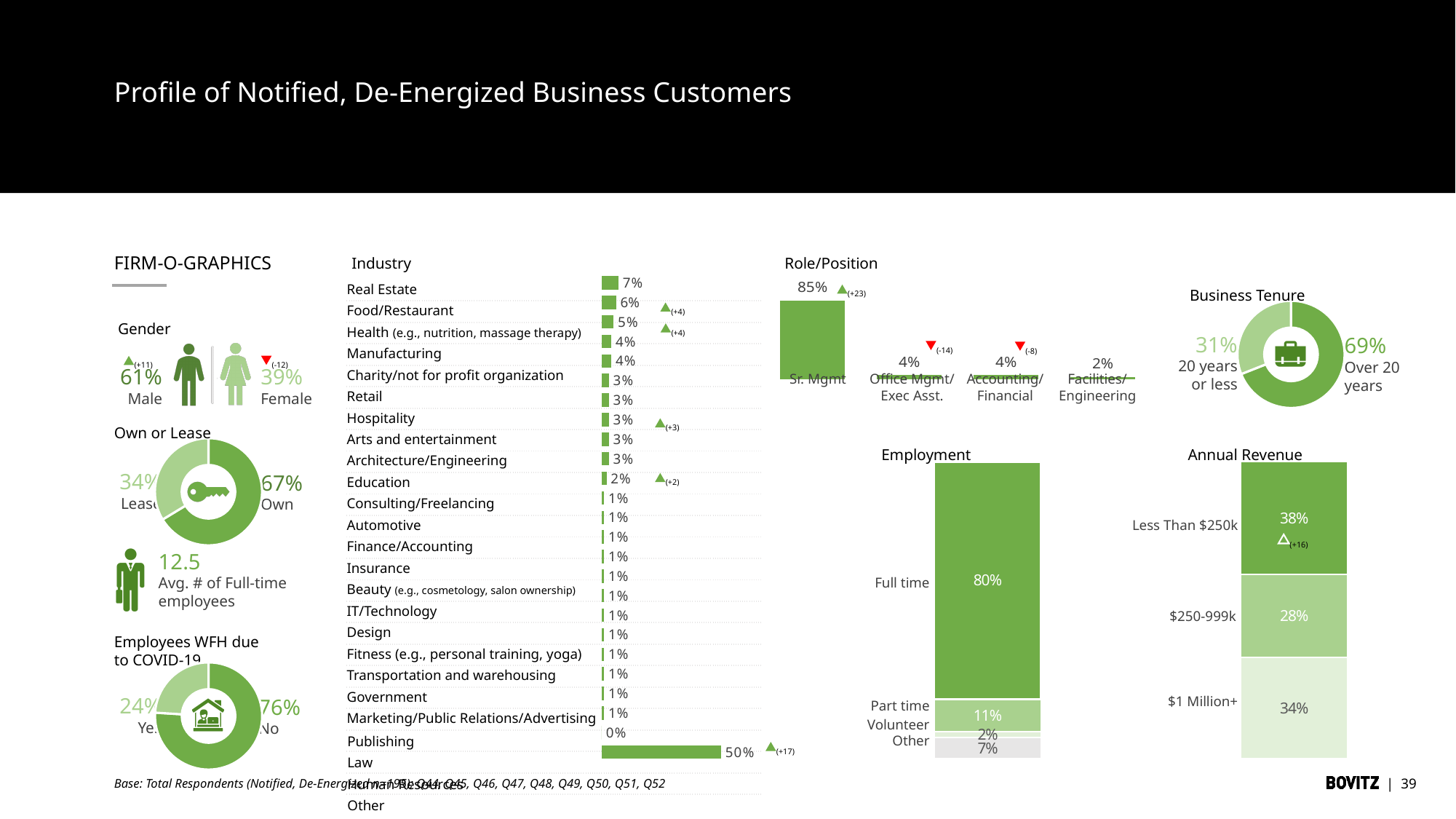
In the Employees WFH due to COVID-19 donut chart, what percentage answered No? 76% In the Annual Revenue chart, which revenue band has the highest percentage? Less Than $250k What kind of chart is used for the Industry breakdown? Bar chart In the Employment chart, what percentage of respondents are Full time? 80% In the Own or Lease donut chart, what percentage of businesses own their premises? 67% In the Employment chart, which category is larger: Part time or Other? Part time In the Role/Position chart, what percentage is shown for Sr. Mgmt? 85% In the Role/Position chart, which role has the lowest percentage? Facilities/Engineering In the Annual Revenue chart, what percentage of businesses have revenue of $1 Million+? 34% In the Role/Position chart, what is the difference between Sr. Mgmt and Facilities/Engineering? 83 percentage points In the Business Tenure donut chart, what share of businesses have been operating over 20 years? 69% In the Employment chart, what is the total of the stacked bar? 100%